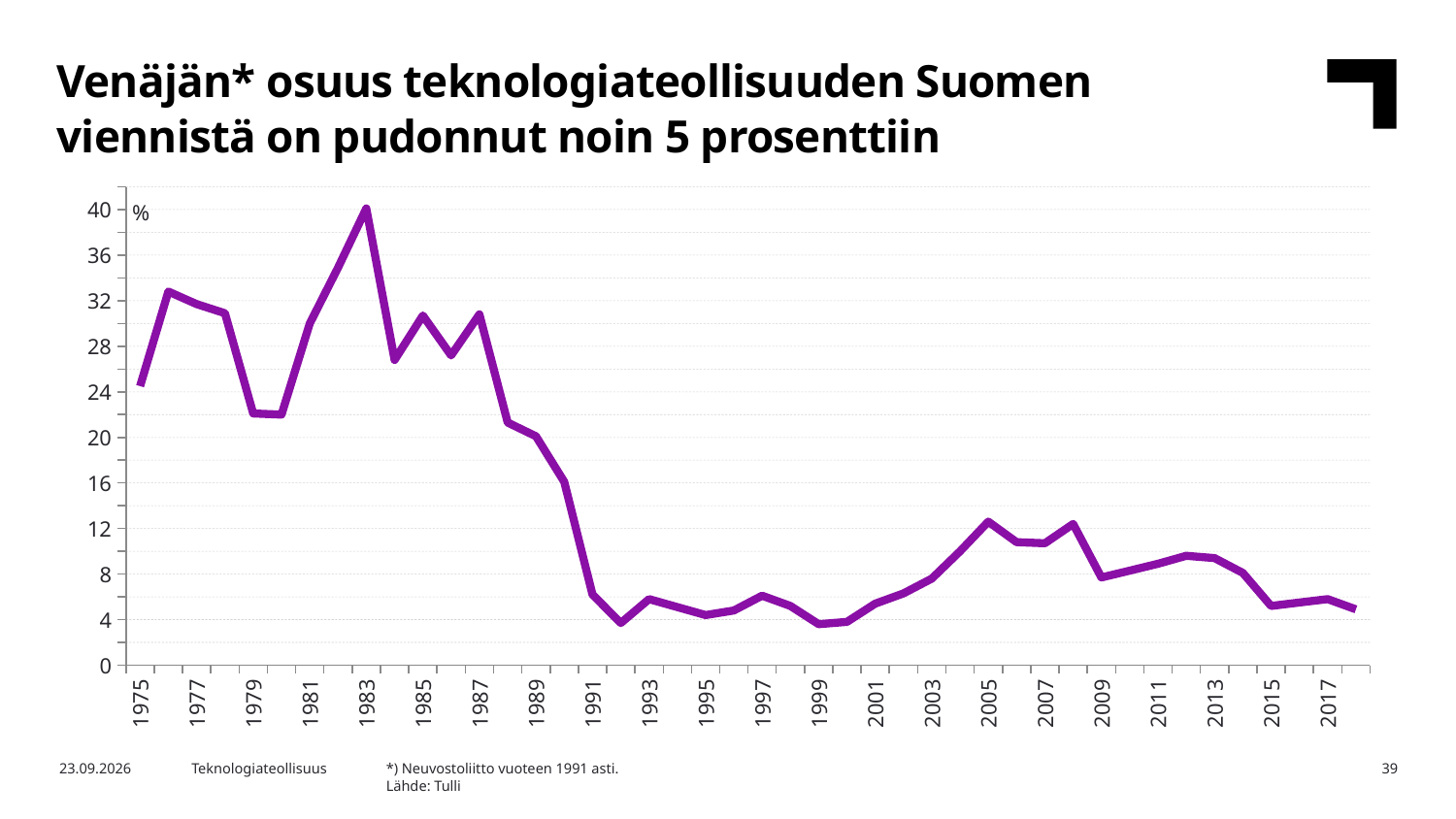
In which year does the line reach its highest value? 1983 Which year has the larger value, 1977 or 1979? 1977 Is the value for 1975 greater or less than 20? greater What kind of chart is shown on the slide? line chart Which year has the larger value, 1983 or 2005? 1983 Is the value for 2005 greater or less than 8? greater Overall, does the line rise or fall from 1975 to the end of the series? fall Is the value for 1992 greater or less than 8? less What unit is shown at the top of the vertical axis? %